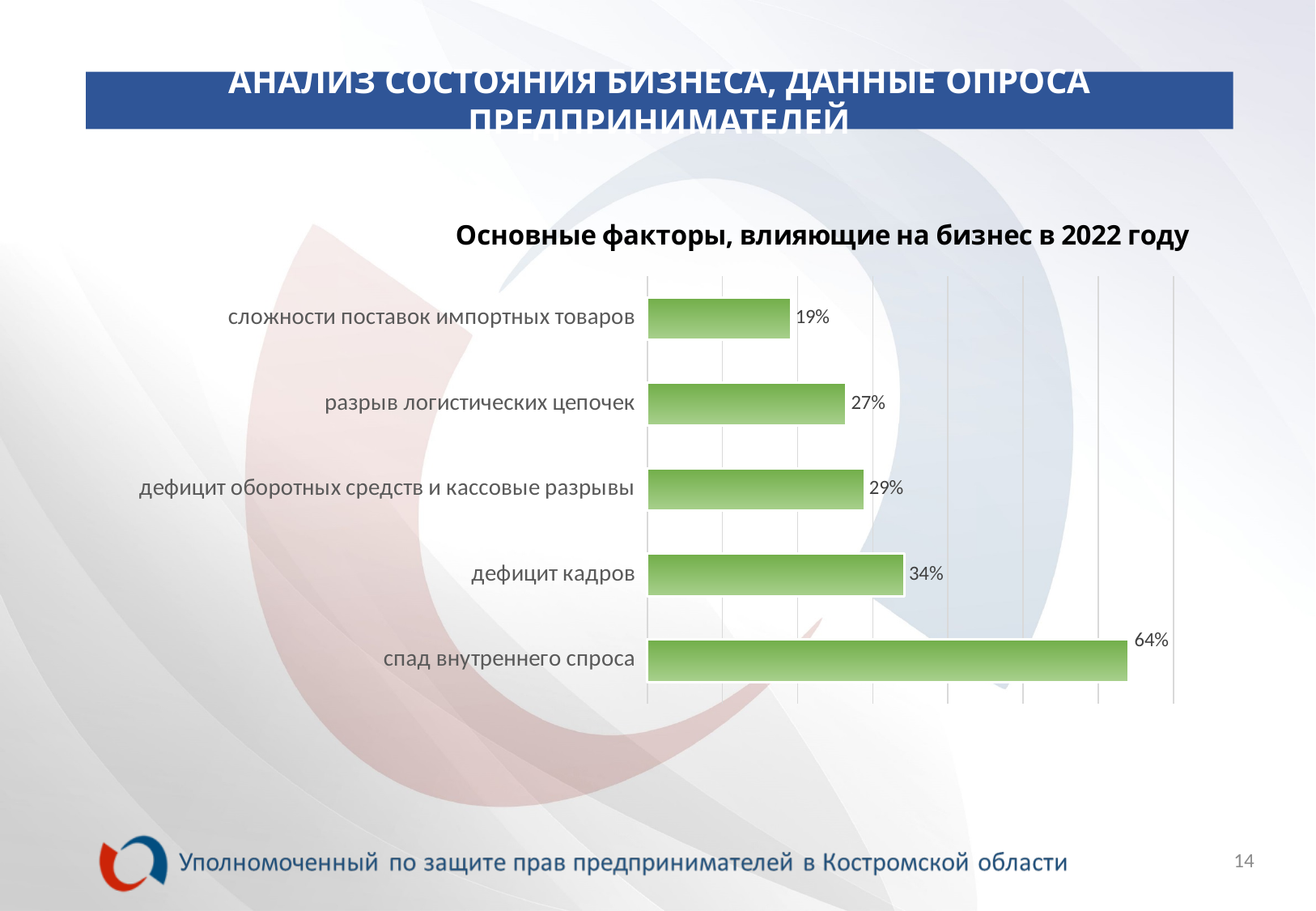
What is the value for «дефицит кадров»? 34% Which is larger: «дефицит кадров» or «разрыв логистических цепочек»? дефицит кадров What is the value for «спад внутреннего спроса»? 64% What is the difference between «спад внутреннего спроса» and «дефицит кадров»? 30% What is the value for «сложности поставок импортных товаров»? 19% Which factor has the lowest value? сложности поставок импортных товаров What kind of chart is shown on the slide? bar chart How many factors are shown in the chart? 5 Which factor has the highest value? спад внутреннего спроса What is the value for «разрыв логистических цепочек»? 27% What is the title of the chart? Основные факторы, влияющие на бизнес в 2022 году What is the difference between «дефицит оборотных средств и кассовые разрывы» and «разрыв логистических цепочек»? 2%